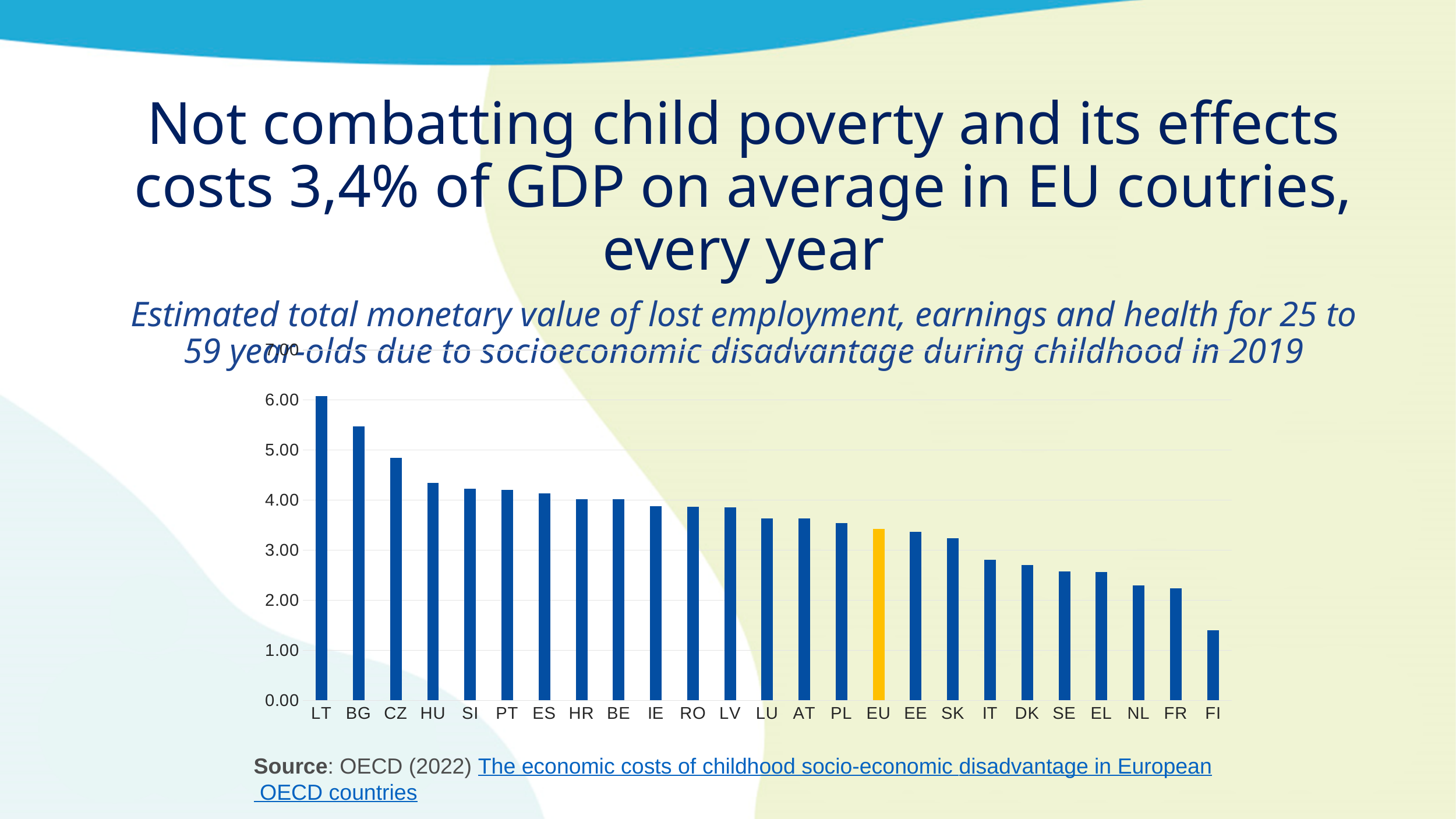
How many countries/categories are plotted along the x axis? 25 Is the value for HU greater or less than 4.00? greater Is the value for IT greater or less than 3.00? less Which category has the highest bar? LT Which category's bar is coloured differently (yellow) from the others? EU Is the value for EU greater or less than 3.00? greater Do the bar values rise or fall moving from left to right along the x axis? fall What kind of chart is shown on the slide? bar chart Which category has the lowest bar? FI Which is larger, the value for BG or the value for CZ? BG